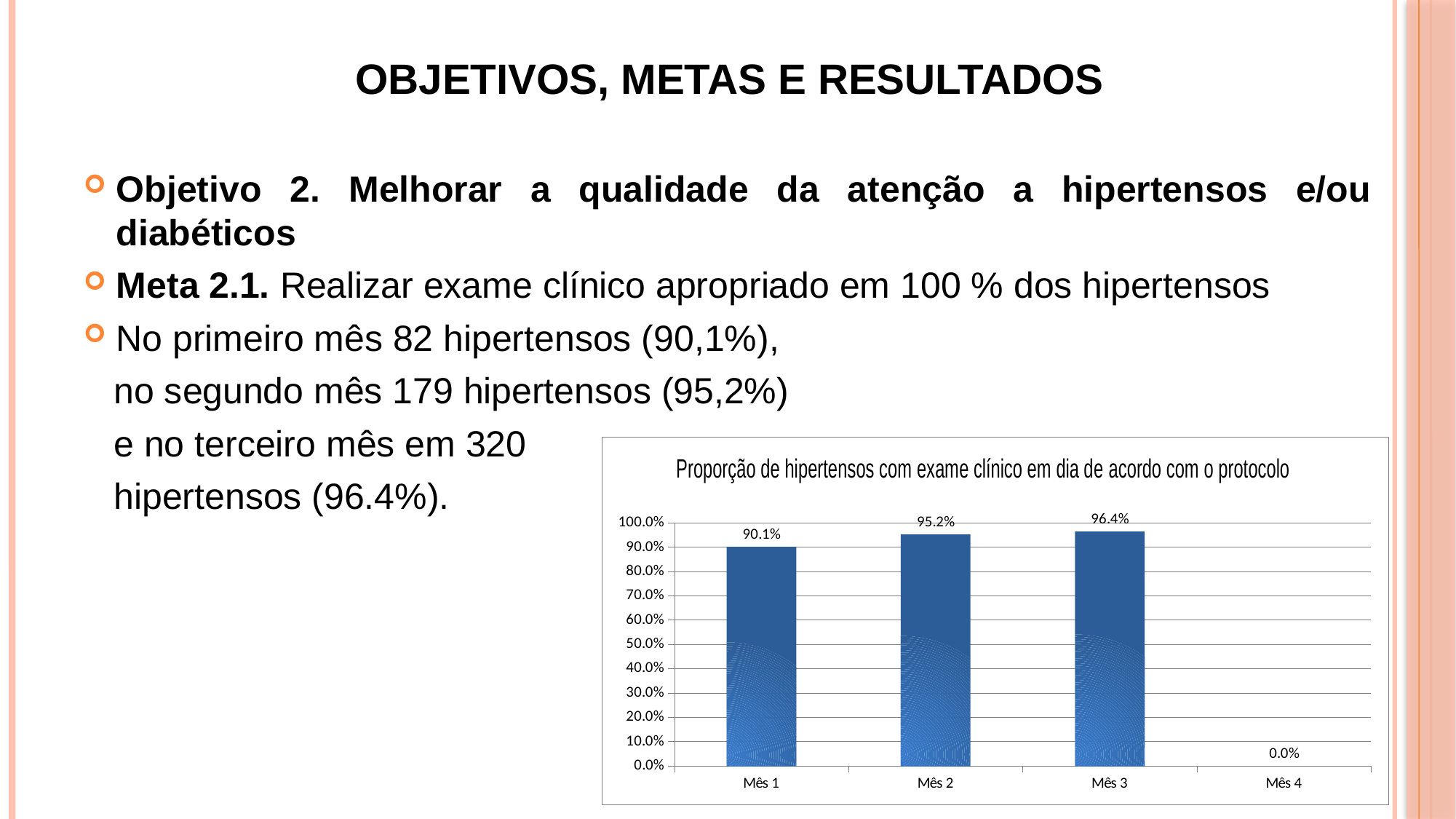
Which month has the lowest value in the chart? Mês 4 What is the difference between the values for Mês 2 and Mês 1? 5.1% How many categories are shown on the x axis of the chart? 4 What is the value for Mês 1 in the chart? 90.1% What is the value for Mês 3 in the chart? 96.4% What is the value for Mês 2 in the chart? 95.2% What is the value for Mês 4 in the chart? 0.0% Which is larger, the value for Mês 1 or the value for Mês 2? Mês 2 Do the values rise or fall from Mês 1 to Mês 3? Rise What is the title of the chart? Proporção de hipertensos com exame clínico em dia de acordo com o protocolo Which month has the highest value in the chart? Mês 3 What kind of chart is shown on the slide? Bar chart